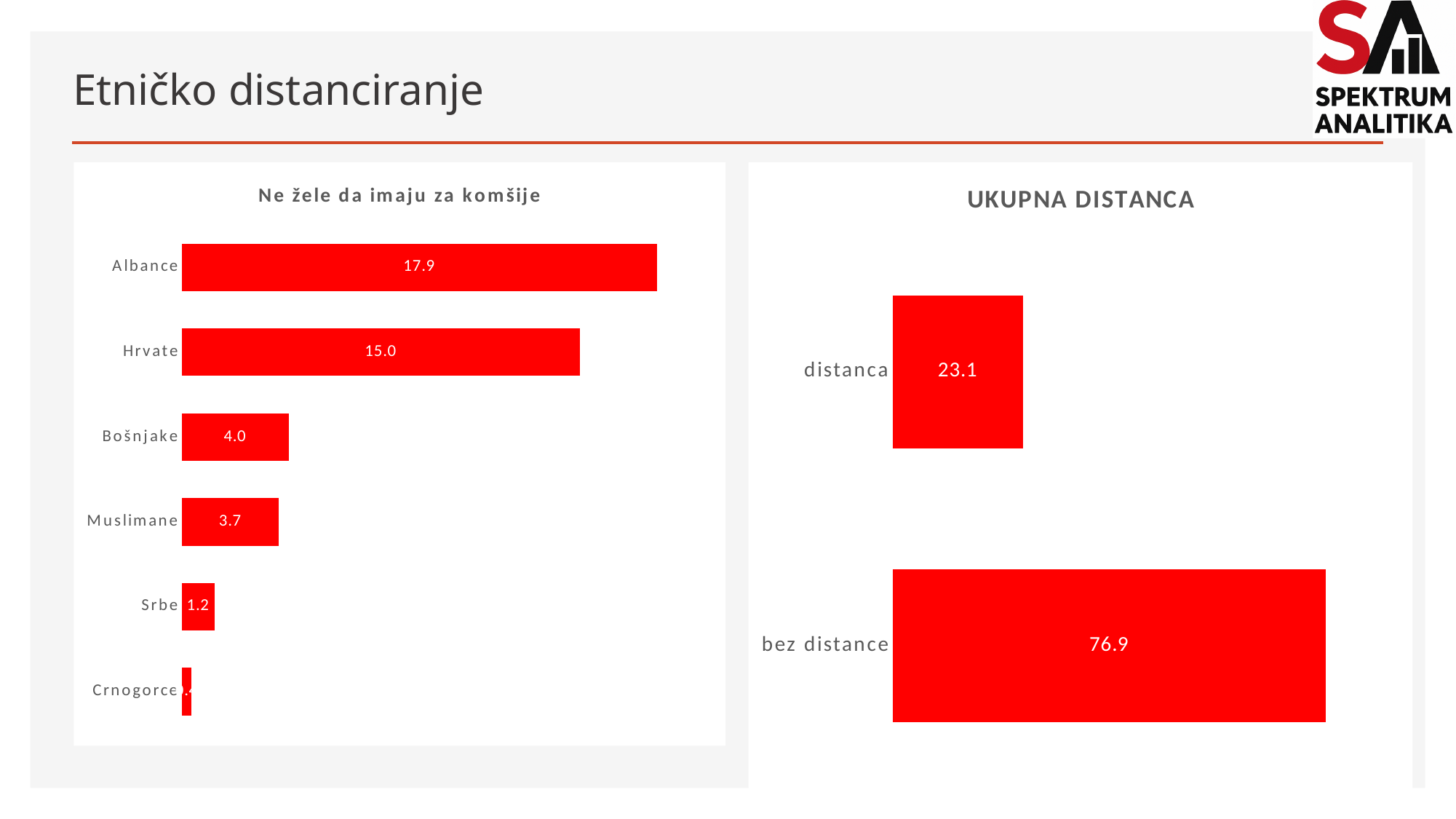
What kind of chart is the chart titled "Ne žele da imaju za komšije"? Bar chart In the chart titled "Ne žele da imaju za komšije", what is the value for Muslimane? 3.7 In the chart titled "Ne žele da imaju za komšije", what is the difference between the values for Albance and Hrvate? 2.9 In the chart titled "UKUPNA DISTANCA", what is the value for distanca? 23.1 In the chart titled "Ne žele da imaju za komšije", which is larger, the value for Bošnjake or the value for Srbe? Bošnjake In the chart titled "Ne žele da imaju za komšije", which category has the lowest value? Crnogorce In the chart titled "Ne žele da imaju za komšije", what is the value for Hrvate? 15.0 How many categories are shown in the chart titled "Ne žele da imaju za komšije"? 6 In the chart titled "Ne žele da imaju za komšije", what is the value for Albance? 17.9 In the chart titled "UKUPNA DISTANCA", what is the difference between the values for bez distance and distanca? 53.8 In the chart titled "UKUPNA DISTANCA", what is the value for bez distance? 76.9 In the chart titled "Ne žele da imaju za komšije", which category has the highest value? Albance